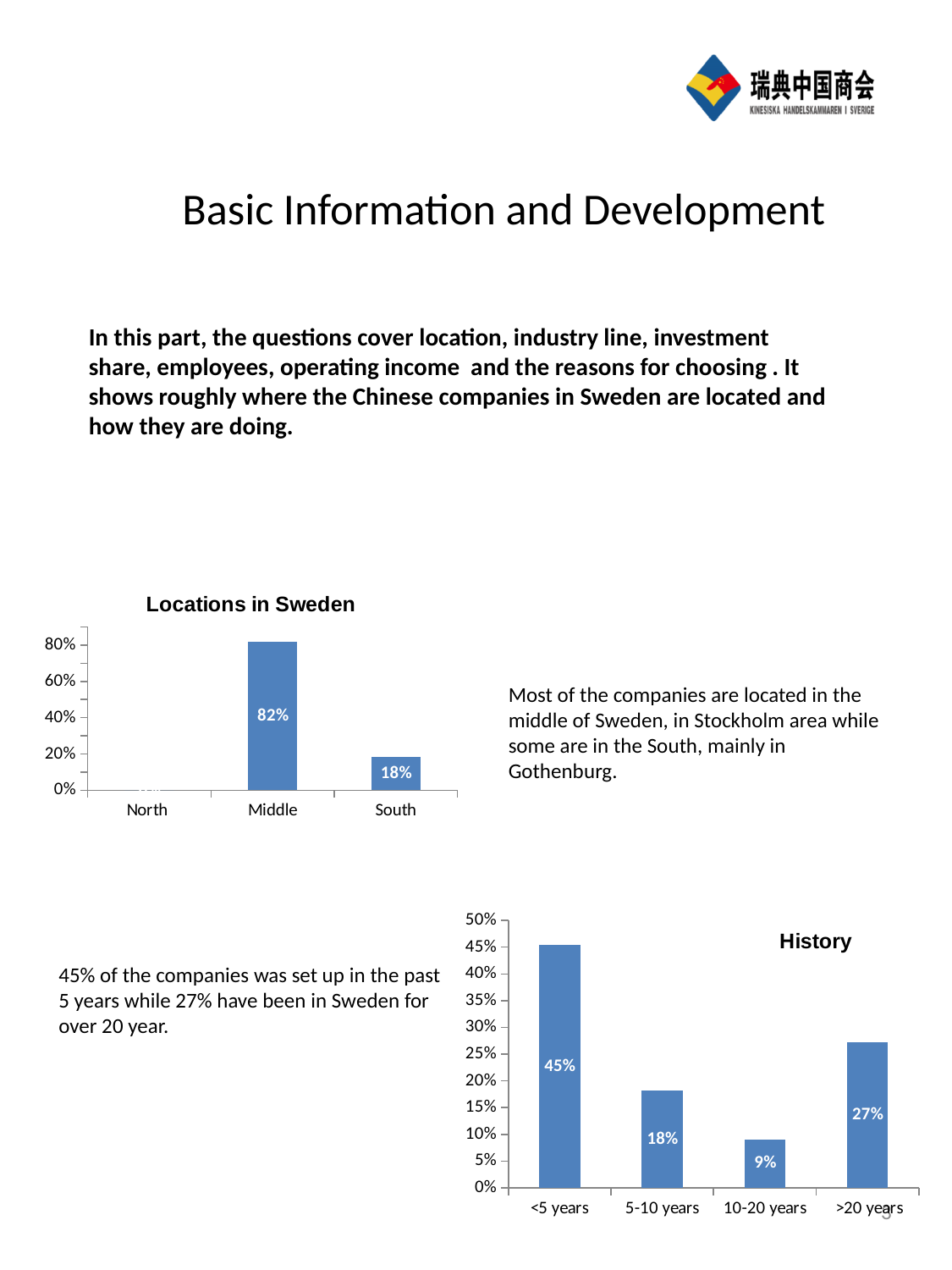
In the 'History' chart, which is larger, the value for 5-10 years or the value for >20 years? >20 years In the 'Locations in Sweden' chart, what is the difference between the values for Middle and South? 64% In the 'Locations in Sweden' chart, how many categories are shown on the x axis? 3 In the 'History' chart, which category has the lowest value? 10-20 years In the 'Locations in Sweden' chart, what is the value for South? 18% In the 'Locations in Sweden' chart, what is the value for Middle? 82% In the 'History' chart, what is the value for 10-20 years? 9% In the 'Locations in Sweden' chart, which category has the highest value? Middle In the 'History' chart, what is the value for <5 years? 45% In the 'History' chart, what is the difference between the values for <5 years and >20 years? 18% In the 'History' chart, what is the value for >20 years? 27% What kind of chart is the 'History' chart? Bar chart